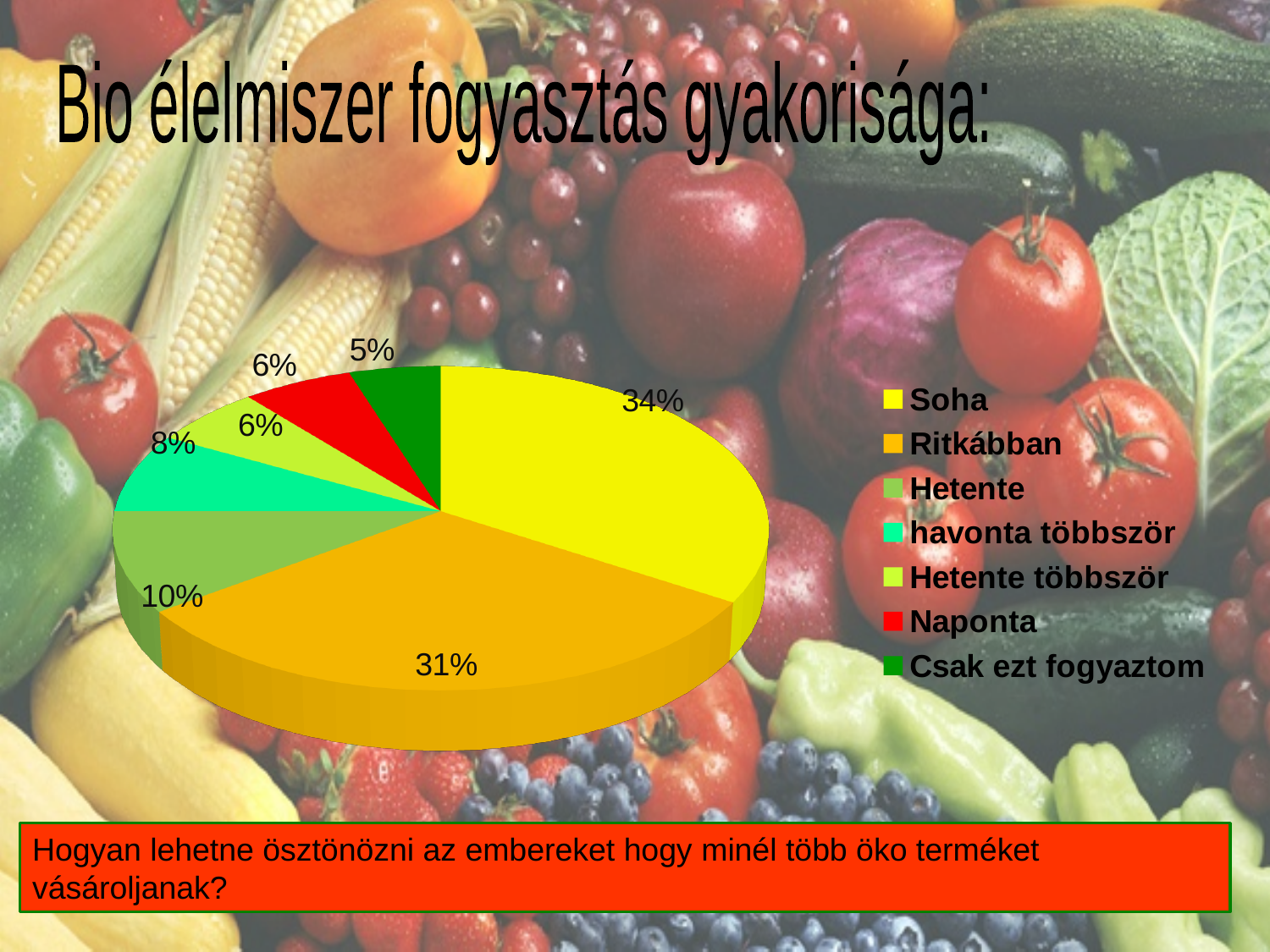
What is the title of the chart? Bio élelmiszer fogyasztás gyakorisága: What is the value for "Csak ezt fogyaztom"? 5% What is the value for "Hetente"? 10% Which category has the largest slice of the pie? Soha What share of the pie does "Soha" have? 34% What is the value for "havonta többször"? 8% Which category has the smallest slice of the pie? Csak ezt fogyaztom What kind of chart is shown on the slide? pie chart What share of the pie does "Ritkábban" have? 31% What is the difference between the shares of "Soha" and "Ritkábban"? 3% How many categories does the legend list? 7 Which is larger, the share for "Hetente" or the share for "Naponta"? Hetente